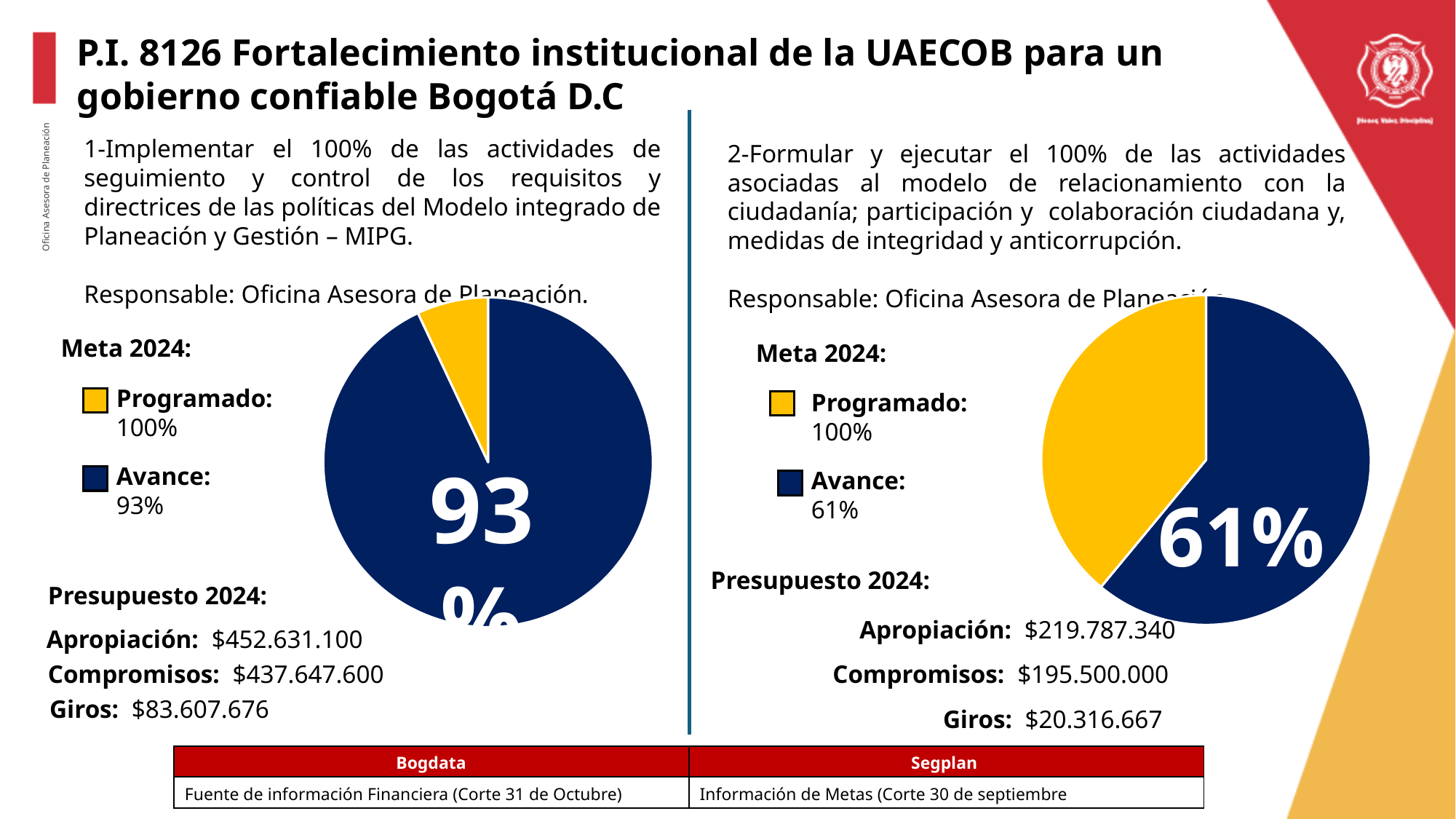
What is the difference between the Avance value in the left pie chart and the Avance value in the right pie chart? 32 percentage points In the right pie chart (goal 2), what is the Avance value? 61% In the right pie chart (goal 2), which slice is larger, the dark blue one or the yellow one? The dark blue one In the left pie chart (goal 1), what is the Avance value? 93% How many entries does the legend of the left pie chart list? 2 Which pie chart shows the higher Avance value, the left one (goal 1) or the right one (goal 2)? The left one (goal 1) What kind of chart is used on the left side of the slide for goal 1? Pie chart In the pie charts, which colour represents Avance? Dark blue How many slices does each pie chart on the slide have? 2 In the right pie chart (goal 2), what is the Programado value shown in the legend? 100% In the right pie chart (goal 2), what share of the pie does the dark blue slice represent? 61% In the left pie chart (goal 1), what share of the pie does the dark blue slice represent? 93%